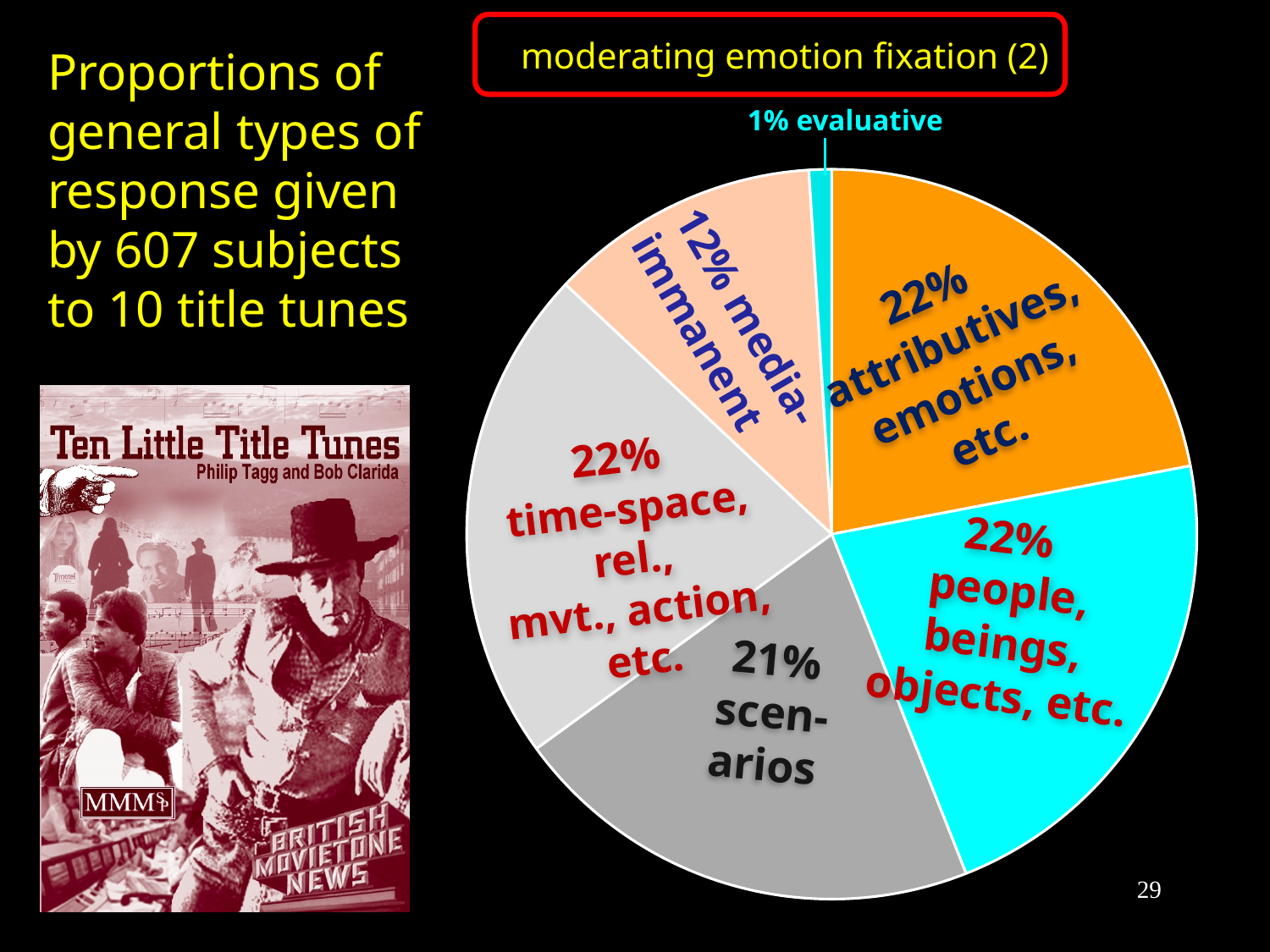
What kind of chart is shown on the slide? pie chart What percentage of responses is labelled 'evaluative'? 1% What percentage of responses is labelled 'time-space, rel., mvt., action, etc.'? 22% What percentage of responses is labelled 'scenarios'? 21% What colour is the 'attributives, emotions, etc.' slice? orange How many slices does the pie chart have? 6 Which is larger: the 'scenarios' slice or the 'media-immanent' slice? scenarios Which slice of the pie chart is the smallest? evaluative What is the difference in percentage points between the 'scenarios' slice and the 'evaluative' slice? 20 What percentage of responses is labelled 'media-immanent'? 12% What percentage of responses is labelled 'people, beings, objects, etc.'? 22% What is the difference in percentage points between the 'attributives, emotions, etc.' slice and the 'media-immanent' slice? 10